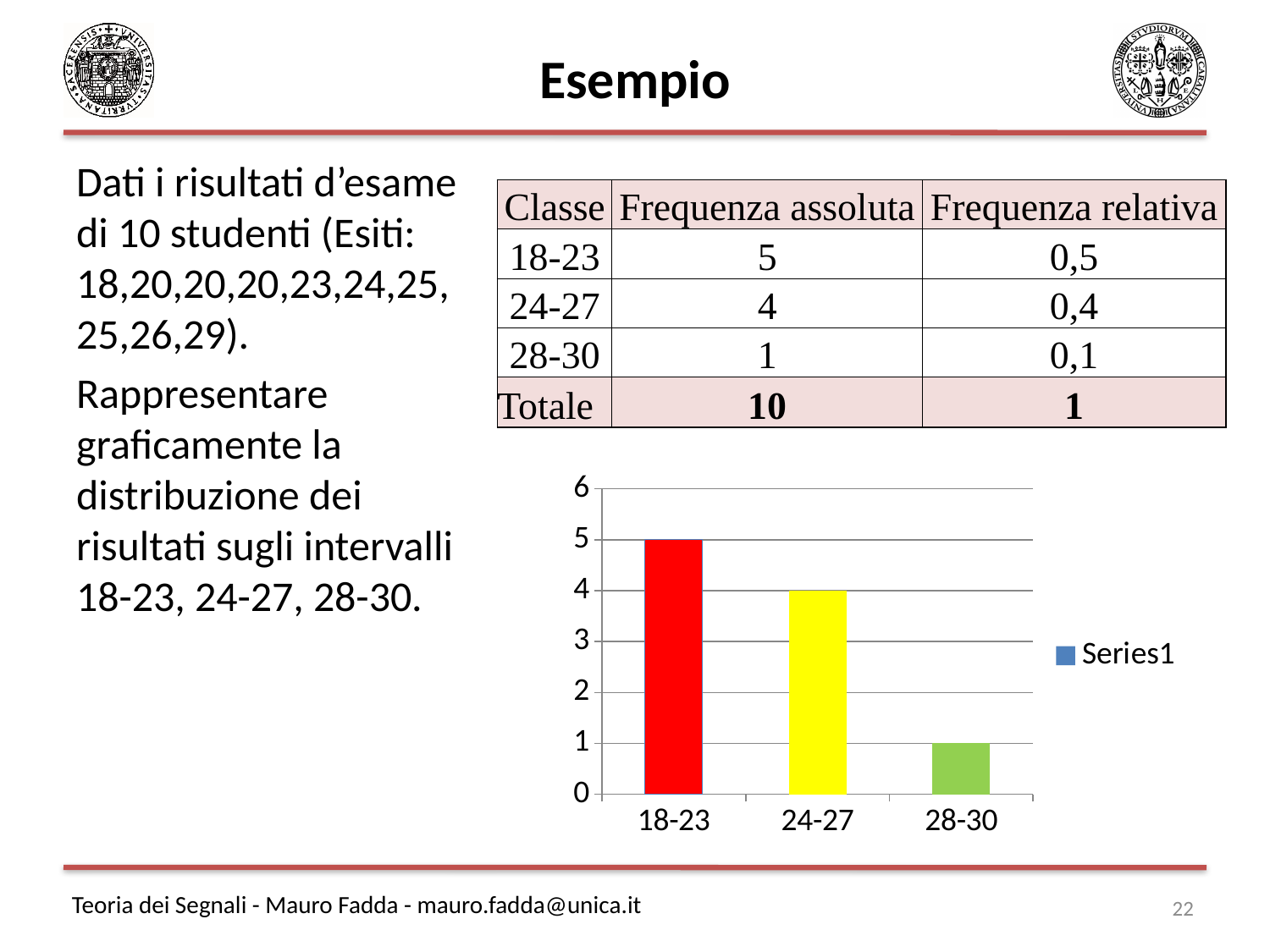
Which bar is taller, 24-27 or 28-30? 24-27 What is the value of the bar for the 24-27 class? 4 Which class has the lowest bar in the chart? 28-30 What is the value of the bar for the 28-30 class? 1 What is the name of the series shown in the chart legend? Series1 What type of chart is shown on the slide? bar chart What is the value of the bar for the 18-23 class? 5 How many categories are shown on the x axis of the chart? 3 What is the difference between the bar values for 18-23 and 28-30? 4 How many series does the chart legend list? 1 Do the bar values rise or fall from left to right along the x axis? fall Which class has the highest bar in the chart? 18-23